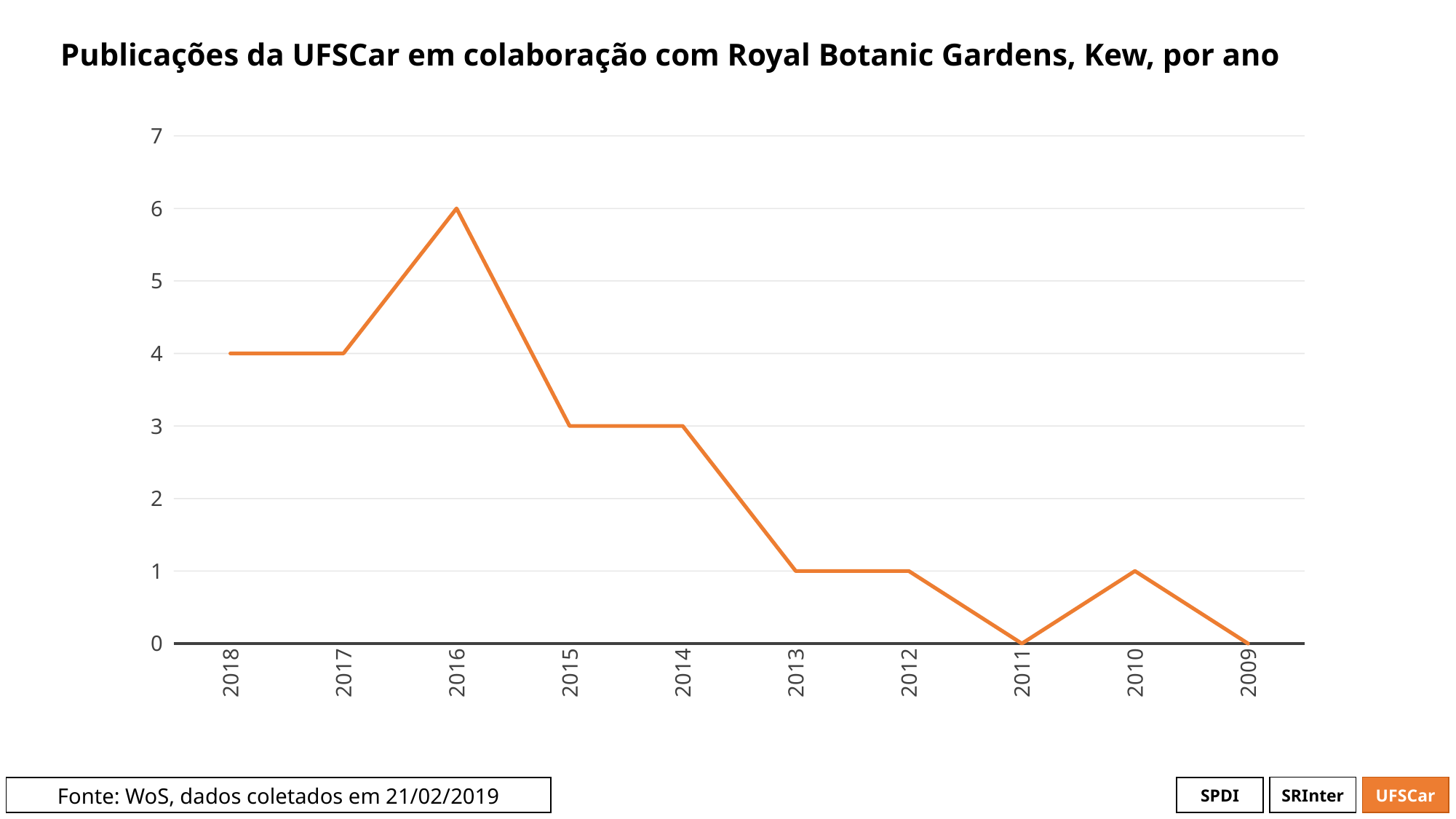
What is the title of the chart? Publicações da UFSCar em colaboração com Royal Botanic Gardens, Kew, por ano What is the value for 2016? 6 Which year has the highest value? 2016 Is the value for 2016 greater or less than 5? greater Do the values generally rise or fall moving from left (2018) to right (2009) along the x axis? fall What is the value for 2015? 3 How many years are shown on the x axis? 10 What is the value for 2018? 4 What is the difference between the values for 2016 and 2014? 3 Which is larger, the value for 2017 or the value for 2013? 2017 What is the value for 2011? 0 What kind of chart is shown on the slide? line chart